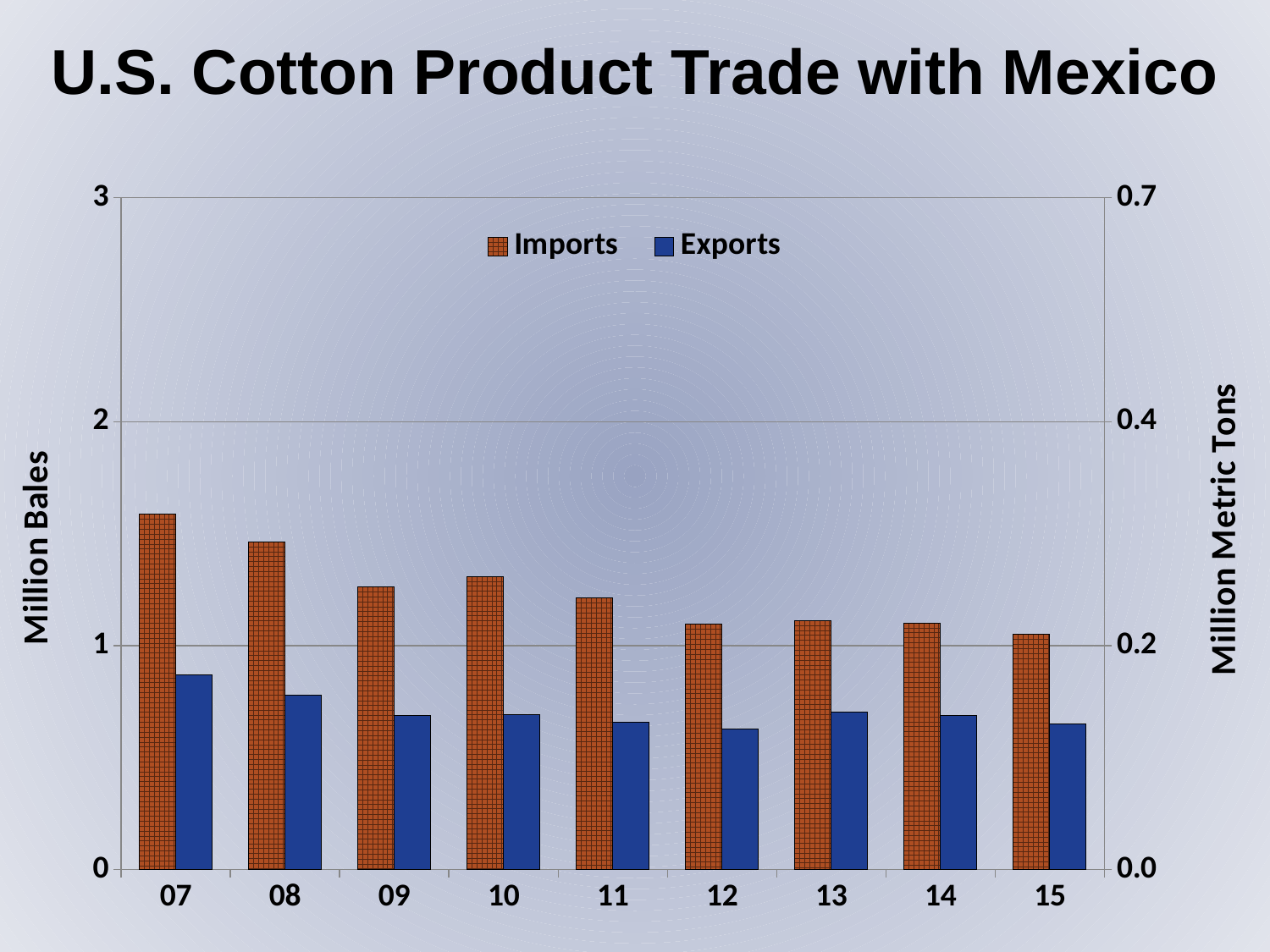
Which year has the highest Imports value? 07 Do Imports generally rise or fall from 07 to 15? fall Is the Exports value for 07 greater or less than 1 million bales? less Which year has the larger Imports value, 07 or 08? 07 Which year has the highest Exports value? 07 How many years are shown on the x axis? 9 How many series does the legend list? 2 What kind of chart is shown on the slide? bar chart What is the label on the left vertical axis? Million Bales Which is larger in 07, Imports or Exports? Imports Is the Imports value for 07 greater or less than 2 million bales? less Is the Imports value for 08 greater or less than 1 million bales? greater